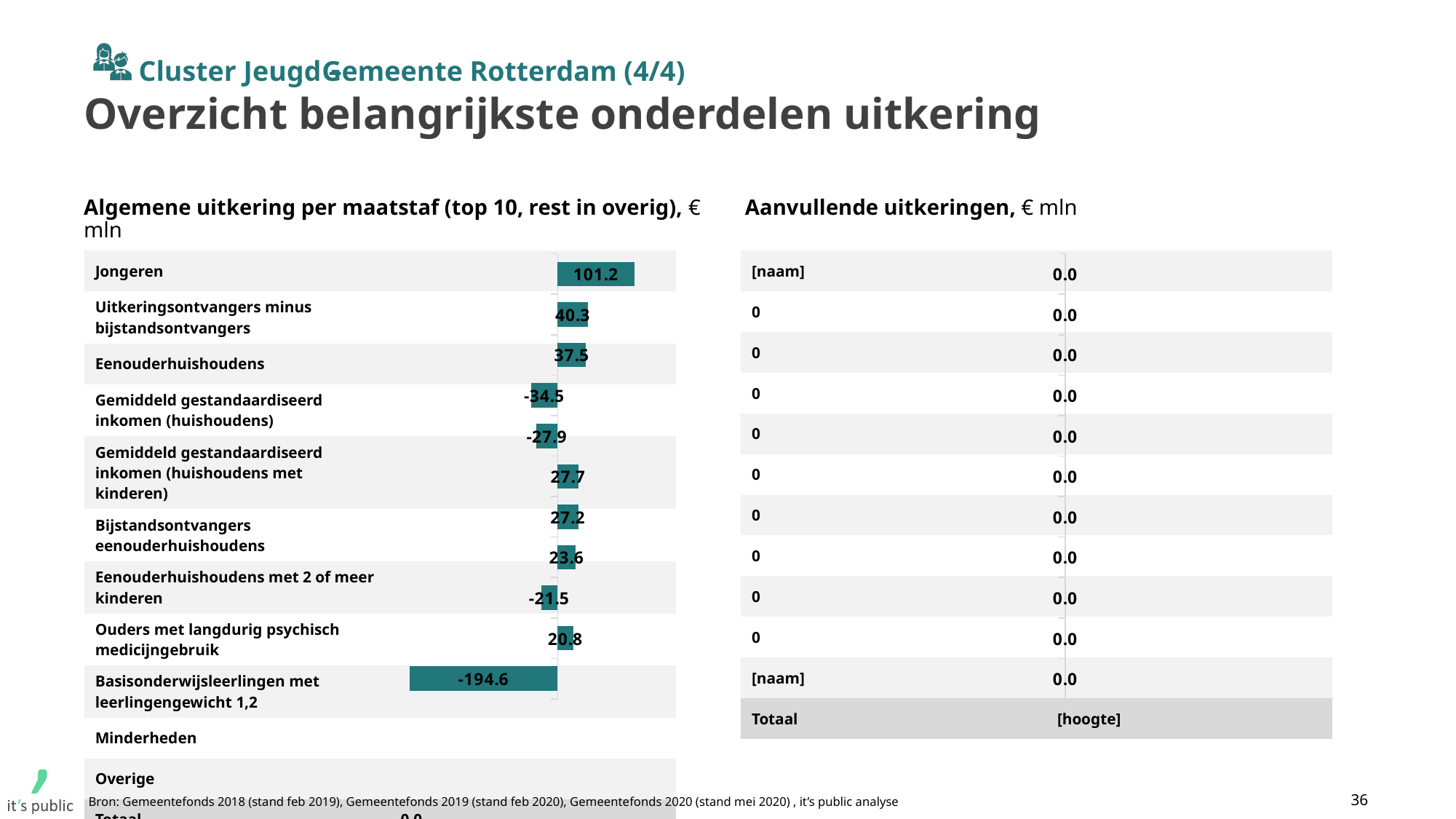
In the chart 'Algemene uitkering per maatstaf', how many bars have a negative value? 4 In the chart 'Algemene uitkering per maatstaf', what is the value for Eenouderhuishoudens? 37.5 In the chart 'Algemene uitkering per maatstaf', which category has the highest value? Jongeren In the chart 'Algemene uitkering per maatstaf', which is larger: the value for Jongeren or the value for Eenouderhuishoudens? Jongeren In the chart 'Algemene uitkering per maatstaf', what is the value for Uitkeringsontvangers minus bijstandsontvangers? 40.3 What is the title of the chart on the right side of the slide? Aanvullende uitkeringen, € mln In the chart 'Algemene uitkering per maatstaf', what is the value for Gemiddeld gestandaardiseerd inkomen (huishoudens)? -34.5 In the chart 'Algemene uitkering per maatstaf', what is the difference between the values for Jongeren and Uitkeringsontvangers minus bijstandsontvangers? 60.9 In the chart 'Algemene uitkering per maatstaf', what is the value for Jongeren? 101.2 What kind of chart is 'Algemene uitkering per maatstaf'? bar chart In the chart 'Aanvullende uitkeringen' on the right, what value is shown for each of the rows? 0.0 In the chart 'Algemene uitkering per maatstaf', what is the lowest value shown on any bar? -194.6